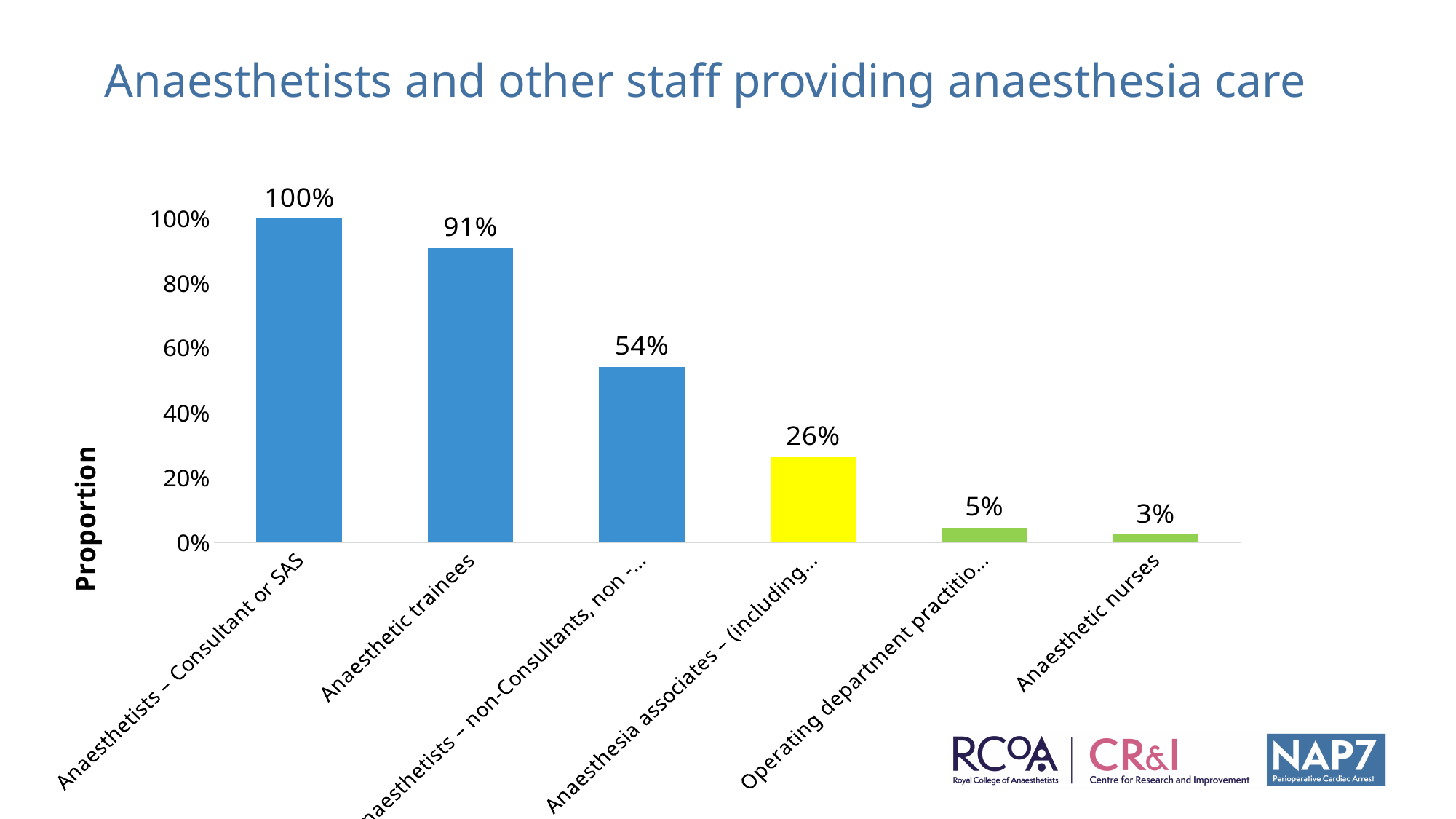
What is the label on the vertical axis? Proportion What is the value for the Anaesthesia associates bar? 26% What is the value for Anaesthetists – Consultant or SAS? 100% Which category has the highest value? Anaesthetists – Consultant or SAS Which is larger, the value for Anaesthetic trainees or the value for Anaesthesia associates? Anaesthetic trainees How many bars are shown in the chart? 6 What is the value for Anaesthetic trainees? 91% Is the value for the Operating department practitioners bar greater or less than 20%? less What is the difference between the values for Anaesthetic trainees and Anaesthetic nurses? 88% What is the value for Anaesthetic nurses? 3% Which category has the lowest value? Anaesthetic nurses What kind of chart is shown on the slide? bar chart